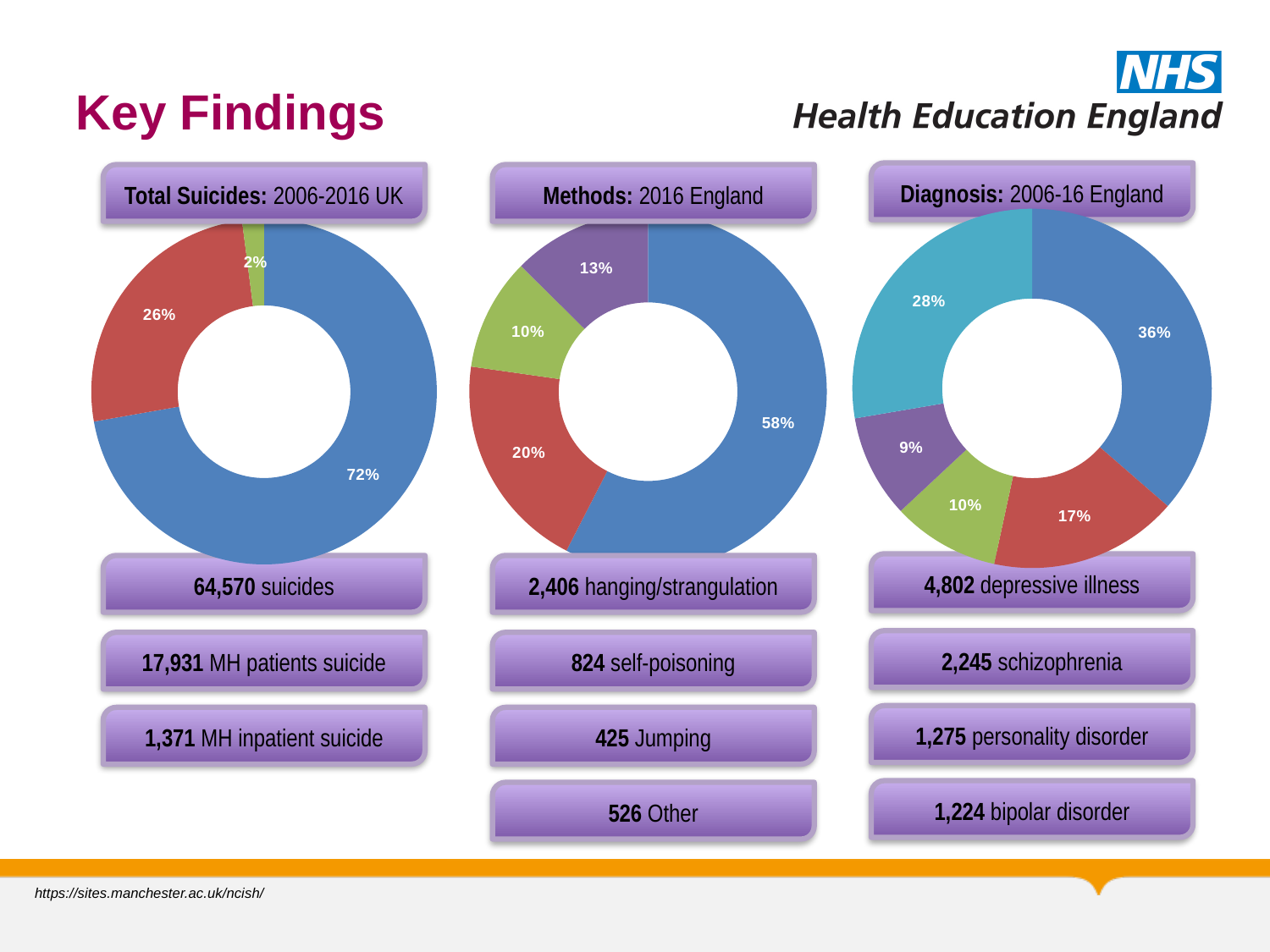
In the 'Methods: 2016 England' chart, what is the difference in percentage points between the 58% slice and the 20% slice? 38 percentage points In the 'Total Suicides: 2006-2016 UK' chart, what is the percentage shown on the smallest slice? 2% How many slices does the 'Total Suicides: 2006-2016 UK' chart have? 3 How many slices does the 'Diagnosis: 2006-16 England' chart have? 5 In the 'Diagnosis: 2006-16 England' chart, what is the percentage shown on the smallest slice? 9% In the 'Diagnosis: 2006-16 England' chart, which is larger: the blue slice or the teal slice? The blue slice (36%) In the 'Total Suicides: 2006-2016 UK' chart, what is the percentage shown on the largest slice? 72% In the 'Methods: 2016 England' chart, what is the percentage shown on the smallest slice? 10% In the 'Methods: 2016 England' chart, what is the percentage shown on the largest slice? 58% What kind of chart is used under the 'Total Suicides: 2006-2016 UK' heading? Doughnut (pie) chart How many slices does the 'Methods: 2016 England' chart have? 4 In the 'Diagnosis: 2006-16 England' chart, what is the percentage shown on the largest slice? 36%